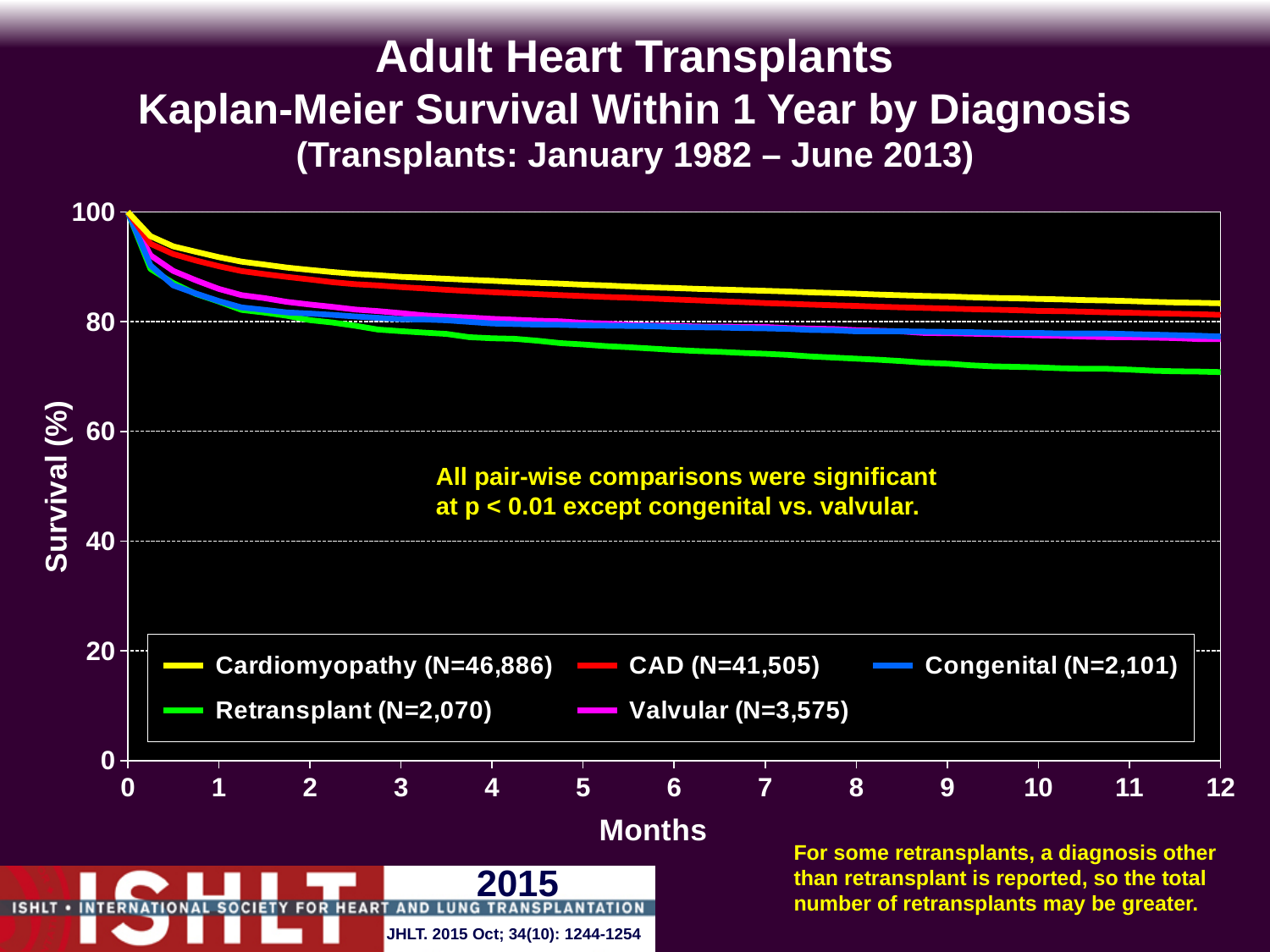
How many series does the legend list? 5 What is the N for the Cardiomyopathy group shown in the legend? 46,886 What is the label of the x axis? Months What kind of chart is shown on the slide? Line chart Which diagnosis group has the highest survival at 12 months? Cardiomyopathy Do the survival curves rise or fall as months increase? Fall Is the survival for Cardiomyopathy at 12 months greater or less than 80? greater Which diagnosis group has the lowest survival at 12 months? Retransplant Is the survival for Retransplant at 12 months greater or less than 80? less At 6 months, which is higher: survival for Cardiomyopathy or for Retransplant? Cardiomyopathy What is the N for the Valvular group shown in the legend? 3,575 What is the N for the CAD group shown in the legend? 41,505